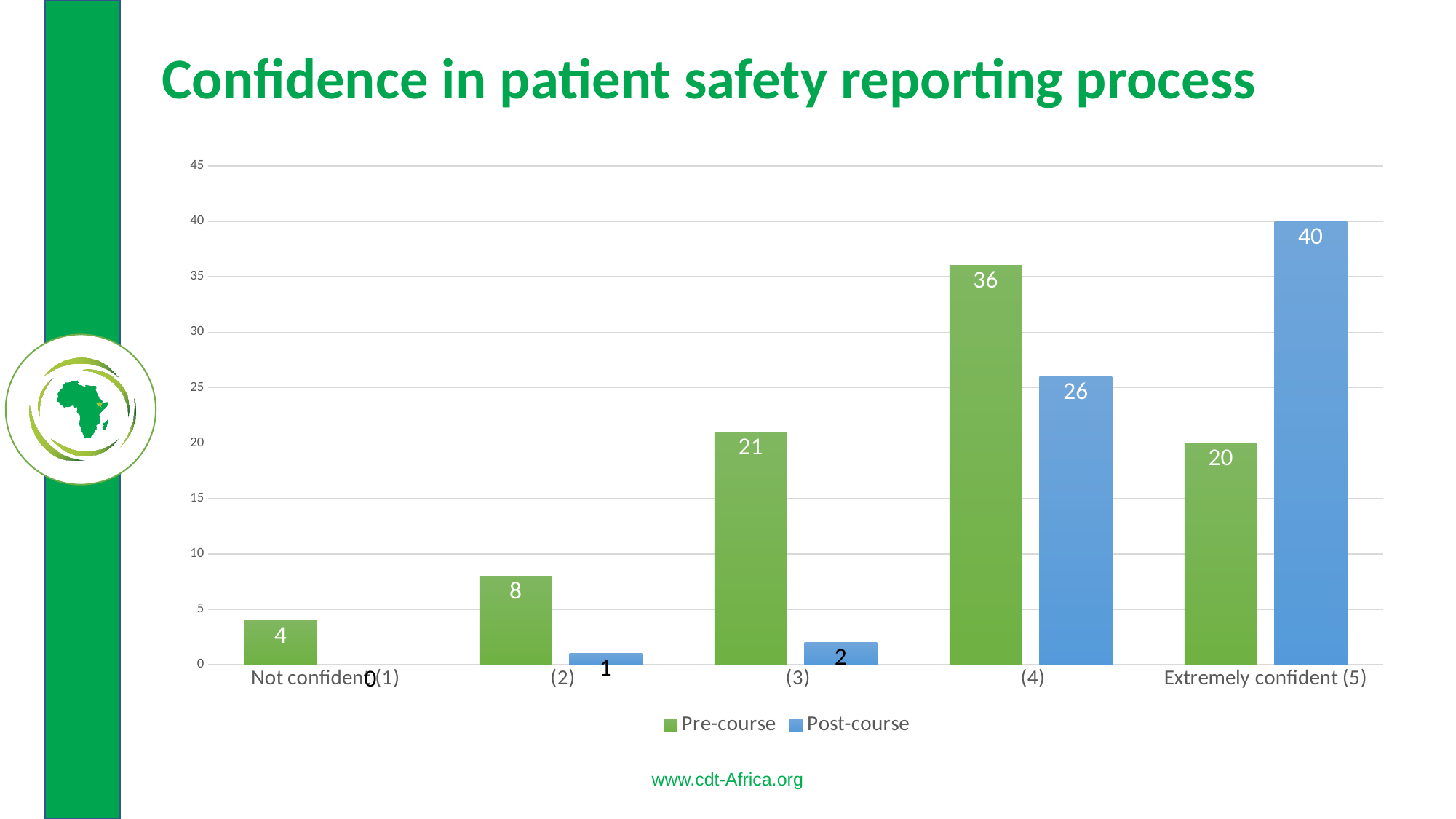
Which category has the lowest Post-course value? Not confident (1) Which category has the highest Pre-course value? (4) How many series does the legend list? 2 How many categories are shown on the x axis? 5 Which is larger for (4): the Pre-course value or the Post-course value? Pre-course What is the Post-course value for Extremely confident (5)? 40 What is the Pre-course value for Not confident (1)? 4 What kind of chart is shown on the slide? Bar chart What is the title of the chart? Confidence in patient safety reporting process What is the difference between the Post-course and Pre-course values for Extremely confident (5)? 20 What is the Post-course value for (3)? 2 What is the Pre-course value for (4)? 36